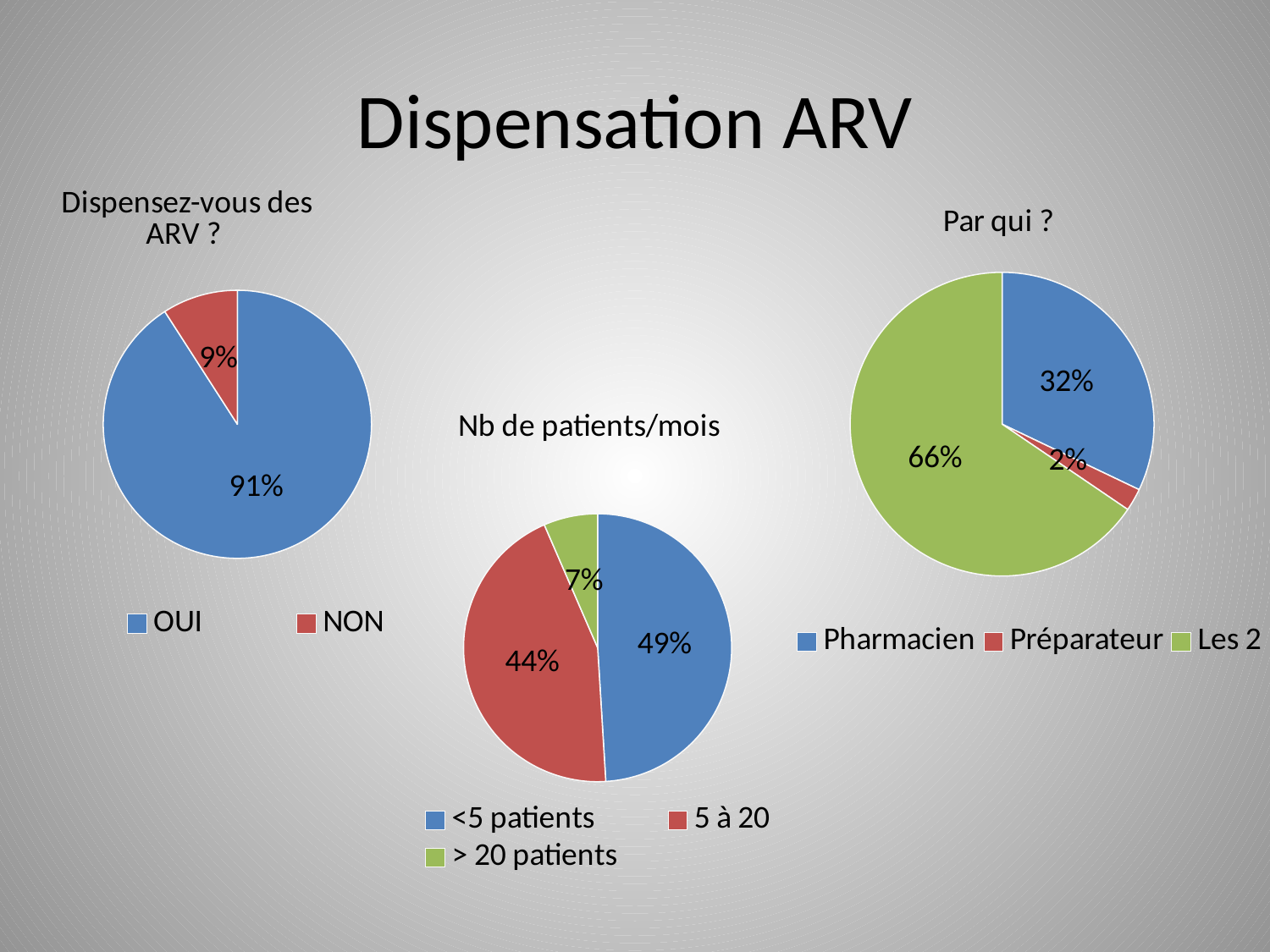
In the 'Dispensez-vous des ARV ?' chart, what share is labelled for OUI? 91% In the 'Dispensez-vous des ARV ?' chart, what kind of chart is shown? pie chart In the 'Nb de patients/mois' chart, what share is labelled for '<5 patients'? 49% In the 'Nb de patients/mois' chart, how many categories does the legend list? 3 In the 'Nb de patients/mois' chart, what share is labelled for '5 à 20'? 44% In the 'Par qui ?' chart, what share is labelled for Préparateur? 2% In the 'Nb de patients/mois' chart, which category has the smallest share? > 20 patients In the 'Par qui ?' chart, what share is labelled for Pharmacien? 32% In the 'Dispensez-vous des ARV ?' chart, what share is labelled for NON? 9% In the 'Par qui ?' chart, what colour is the Les 2 slice? green In the 'Par qui ?' chart, which category has the largest share? Les 2 In the 'Nb de patients/mois' chart, what is the difference between the shares for '<5 patients' and '5 à 20'? 5%